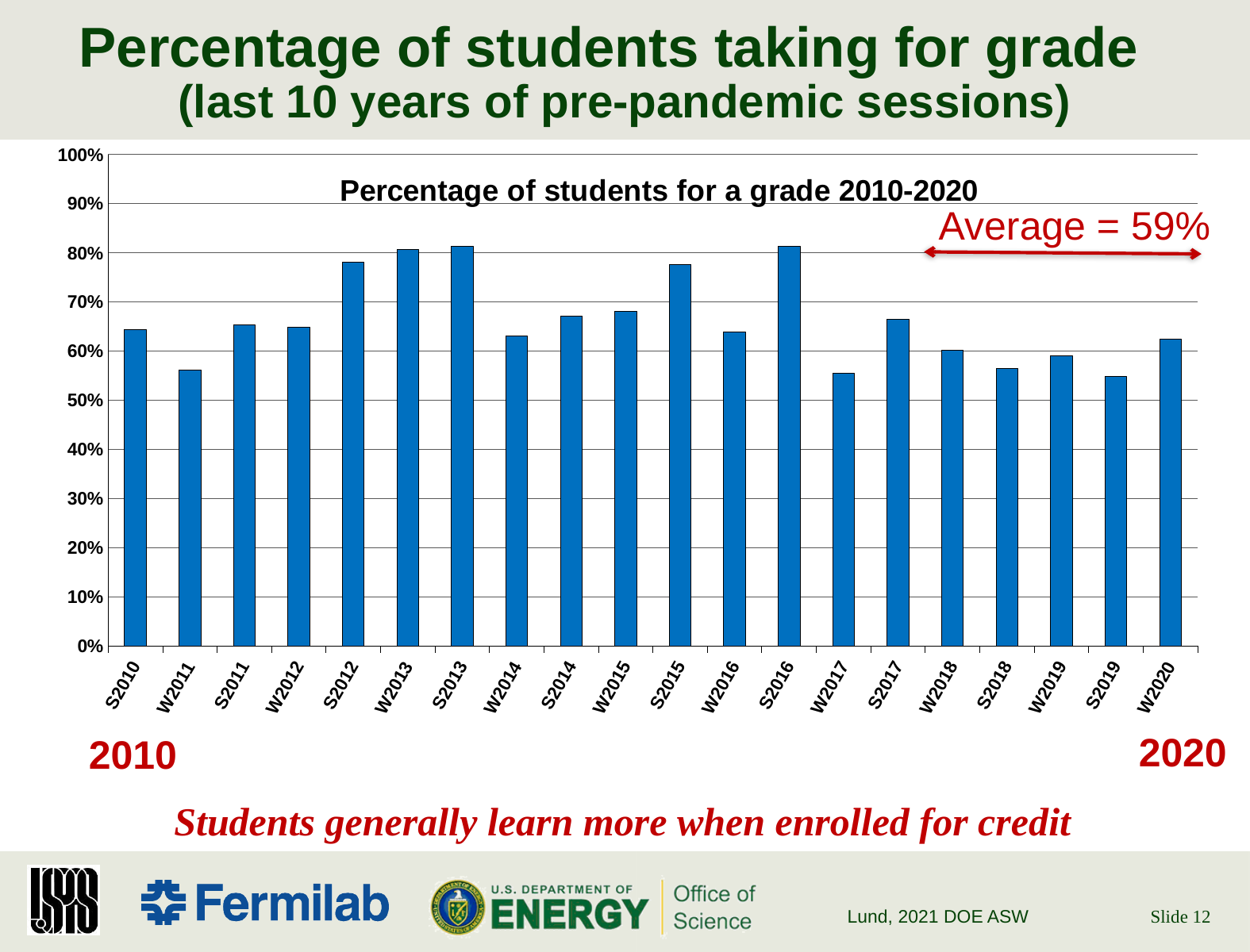
Which has the larger value, W2013 or W2014? W2013 What kind of chart is shown on the slide? bar chart Is the value for S2012 greater or less than 70%? greater Is the value for W2017 greater or less than 60%? less Which has the larger value, S2012 or W2011? S2012 How many sessions (bars) are plotted in the chart? 20 Is the value for S2015 greater or less than 70%? greater What is the title printed inside the chart area? Percentage of students for a grade 2010-2020 Which has the larger value, S2016 or S2019? S2016 What average value is annotated on the chart? 59%